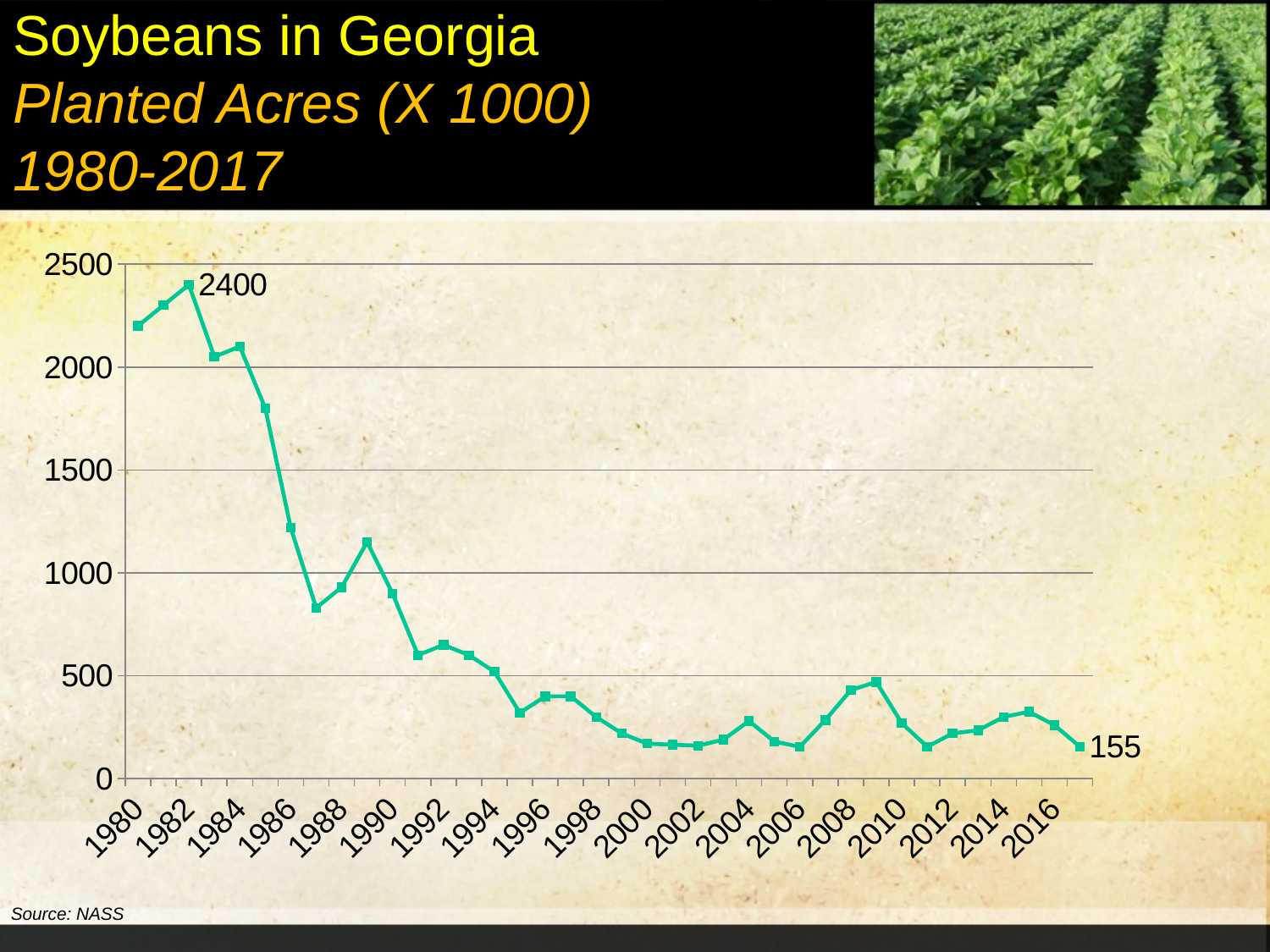
What is the planted acres value labeled for 1982? 2400 What is the highest value shown on the y axis? 2500 Is the value for 1986 greater or less than 1500? less What is the difference between the labeled values for 1982 and 2017? 2245 Which year has the larger planted acres value, 1982 or 2017? 1982 What source is cited for the chart data? NASS What kind of chart is shown on the slide? line chart In which year were planted acres highest? 1982 What is the planted acres value labeled for the last point, 2017? 155 Overall, do planted acres rise or fall from 1980 to 2017? fall Is the value for 1980 greater or less than 2000? greater Is the value for 2000 greater or less than 500? less